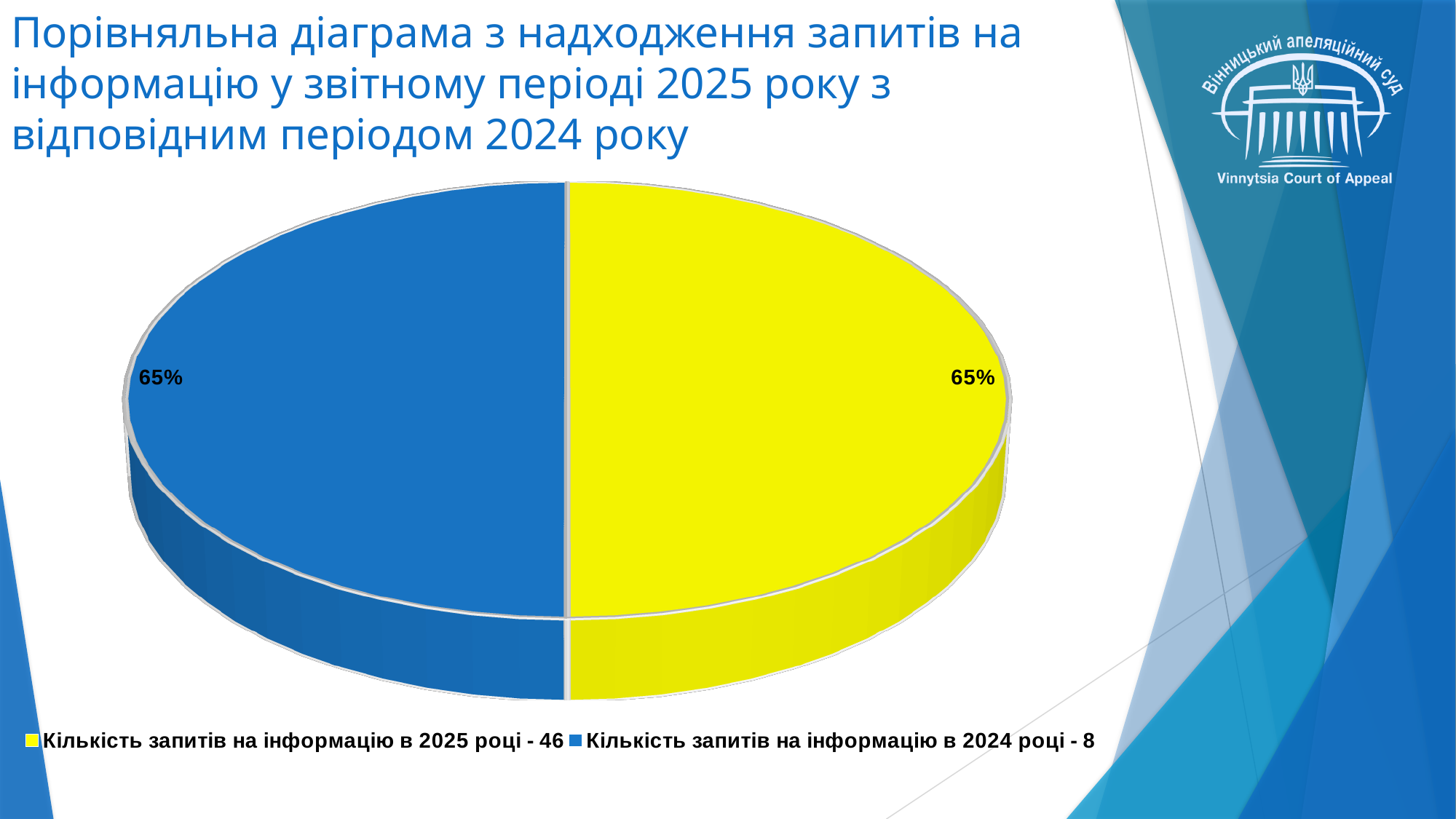
Which colour represents the number of information requests in 2024? blue Which year had more information requests according to the legend, 2025 or 2024? 2025 What percentage label is shown on the blue slice? 65% What percentage label is shown on the yellow slice? 65% What is the difference between the number of information requests in 2025 and in 2024 as given in the legend? 38 How many slices does the pie chart have? 2 How many entries does the legend list? 2 What kind of chart is shown on the slide? pie chart Which colour represents the number of information requests in 2025? yellow According to the legend, how many information requests were received in 2024? 8 According to the legend, how many information requests were received in 2025? 46